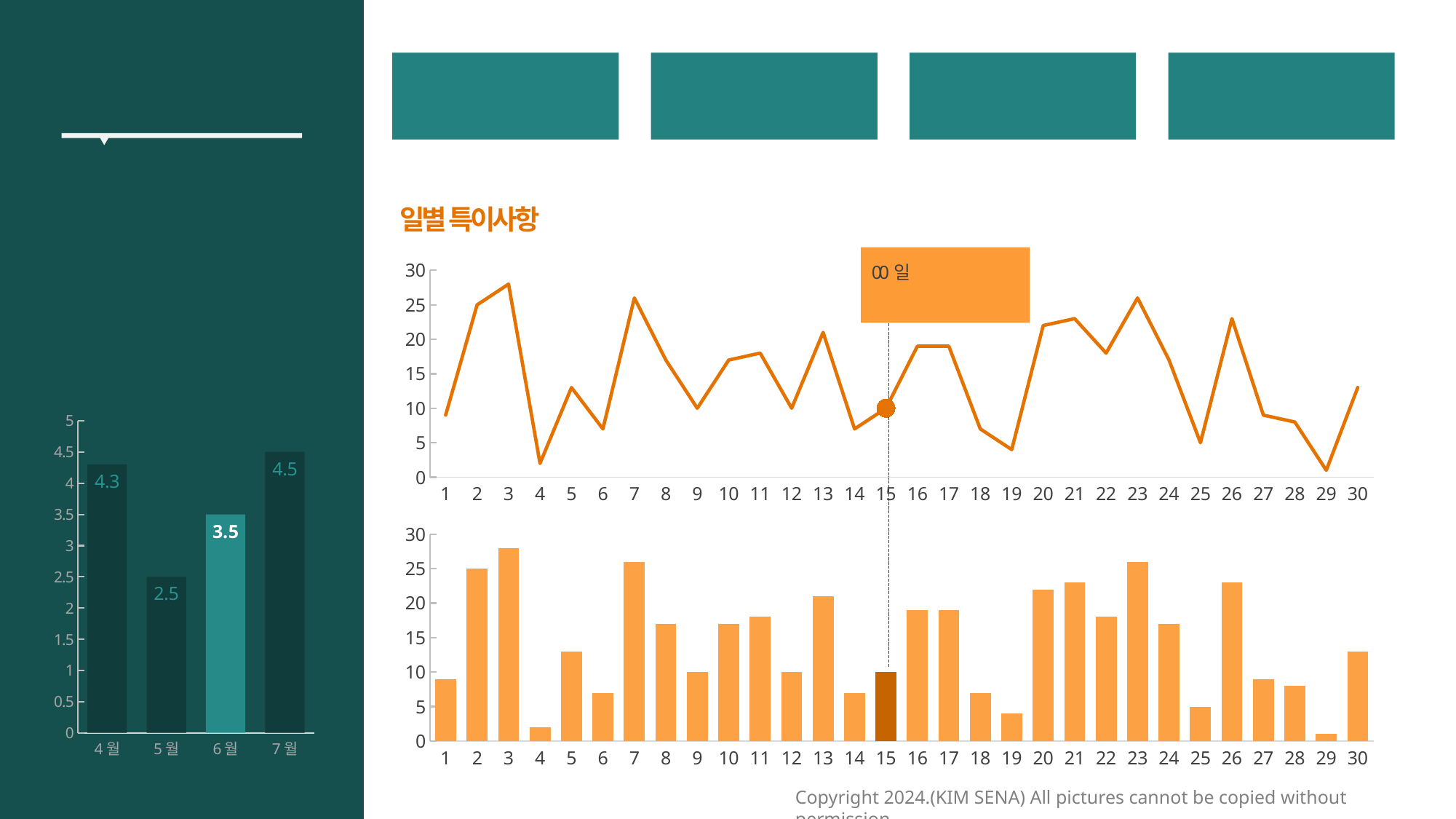
On the bottom right bar chart, is the value for day 19 greater or less than 5? less How many categories are shown on the left bar chart? 4 On the top right line chart, is the value for day 4 greater or less than 5? less On the left bar chart, what is the difference between the values for 7월 and 5월? 2 On the top right line chart, is the value for day 3 greater or less than 25? greater On the left bar chart, which month has the lowest value? 5월 On the left bar chart, what is the value for 4월? 4.3 On the left bar chart, what is the value for 6월? 3.5 How many data points are plotted on the top right line chart? 30 On the left bar chart, which month has the highest value? 7월 On the bottom right bar chart, which day has the highest bar? 3 On the left bar chart, which is larger, the value for 4월 or the value for 6월? 4월